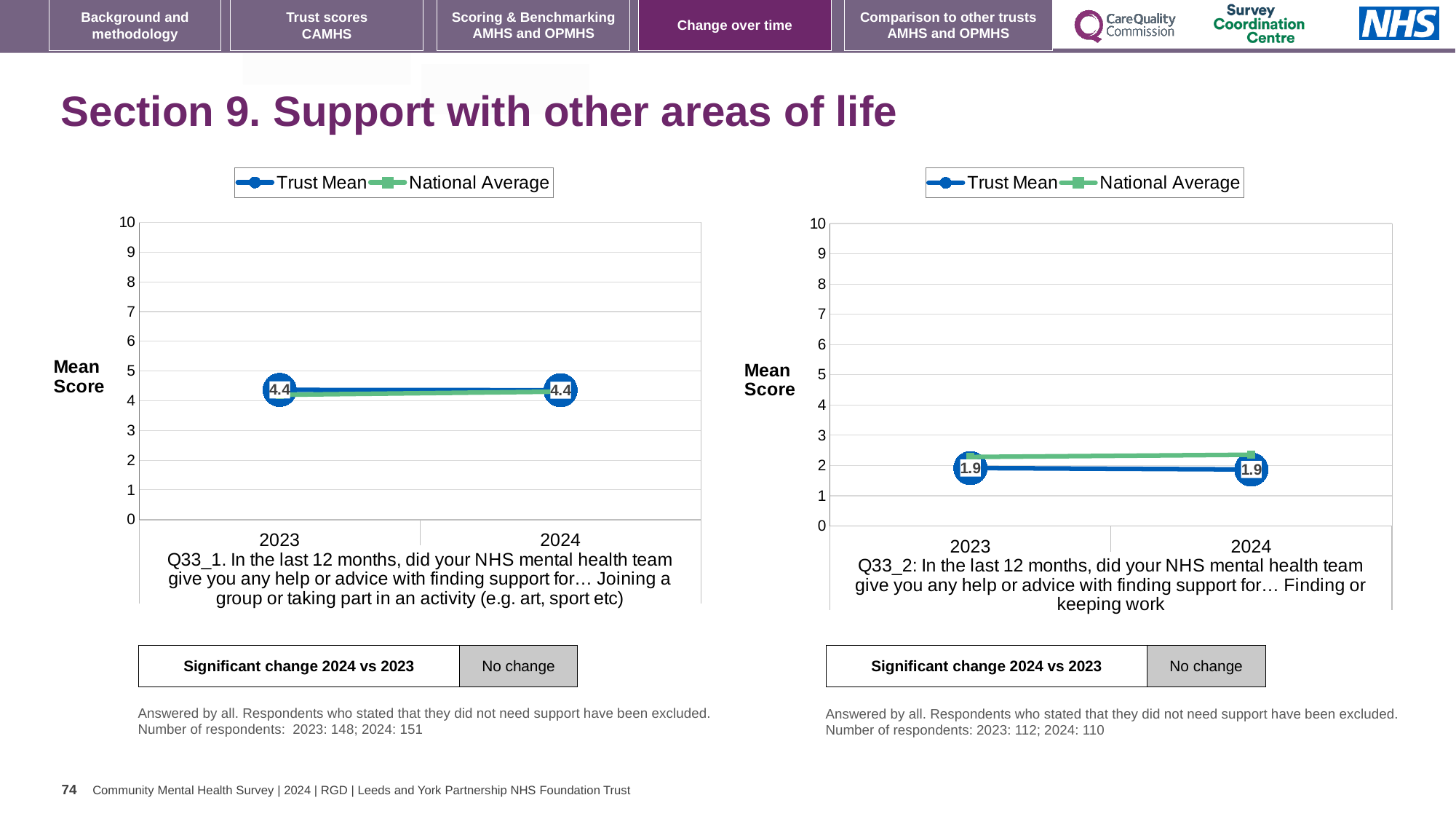
On the right chart (Q33_2), what is the Trust Mean for 2023? 1.9 On the right chart (Q33_2), what is the Trust Mean for 2024? 1.9 What is the difference between the Trust Mean for 2024 and 2023 on the left chart (Q33_1)? 0 On the left chart (Q33_1), is the National Average for 2024 greater or less than 5? less On the right chart (Q33_2), which is higher in 2024: the Trust Mean or the National Average? National Average On the left chart (Q33_1), what is the Trust Mean for 2023? 4.4 On the right chart (Q33_2), is the National Average for 2023 greater or less than 2? greater What kind of chart is the left chart (Q33_1)? Line chart On the right chart (Q33_2), does the Trust Mean rise, fall or stay the same from 2023 to 2024? Stays the same On the left chart (Q33_1), what is the Trust Mean for 2024? 4.4 How many years are plotted on the x axis of the left chart (Q33_1)? 2 How many series does the legend of the right chart (Q33_2) list? 2